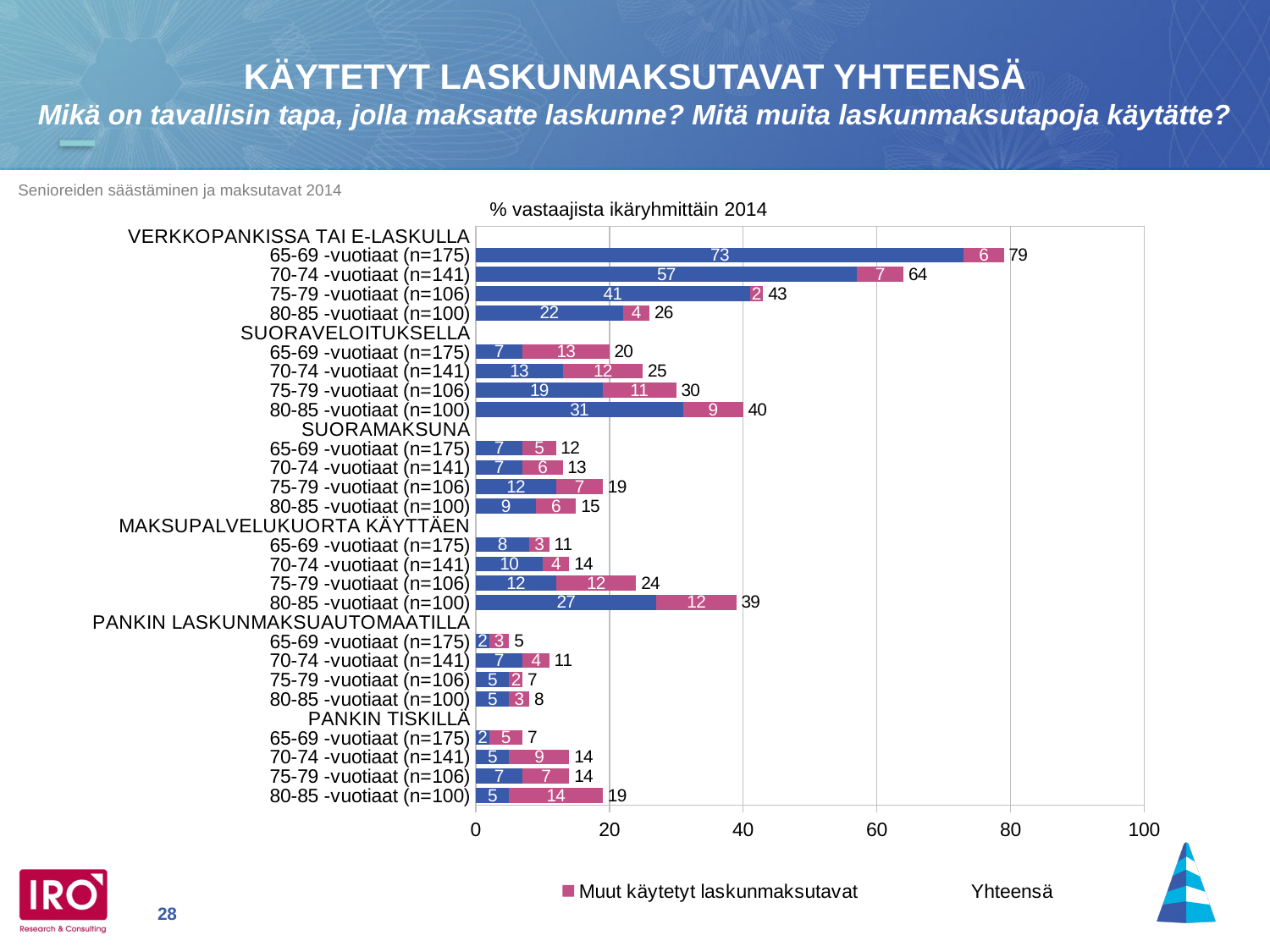
What is the total value shown for 65-69 -vuotiaat (n=175) under VERKKOPANKISSA TAI E-LASKULLA? 79 Under SUORAMAKSUNA, which age group has the larger total: 75-79 -vuotiaat or 80-85 -vuotiaat? 75-79 -vuotiaat What is the title of the chart? % vastaajista ikäryhmittäin 2014 What is the value of the blue segment for 70-74 -vuotiaat (n=141) under VERKKOPANKISSA TAI E-LASKULLA? 57 What is the difference between the total for 65-69 -vuotiaat and the total for 80-85 -vuotiaat under VERKKOPANKISSA TAI E-LASKULLA? 53 What is the value of the pink segment (Muut käytetyt laskunmaksutavat) for 80-85 -vuotiaat (n=100) under MAKSUPALVELUKUORTA KÄYTTÄEN? 12 How many age groups are shown for each payment method? 4 What is the total value for 80-85 -vuotiaat (n=100) under SUORAVELOITUKSELLA? 40 What kind of chart is shown on the slide? Stacked bar chart Which bar has the lowest total value on the chart? 65-69 -vuotiaat (n=175), PANKIN LASKUNMAKSUAUTOMAATILLA Which bar has the highest total value on the chart? 65-69 -vuotiaat (n=175), VERKKOPANKISSA TAI E-LASKULLA What is the total value for 80-85 -vuotiaat (n=100) under PANKIN TISKILLÄ? 19